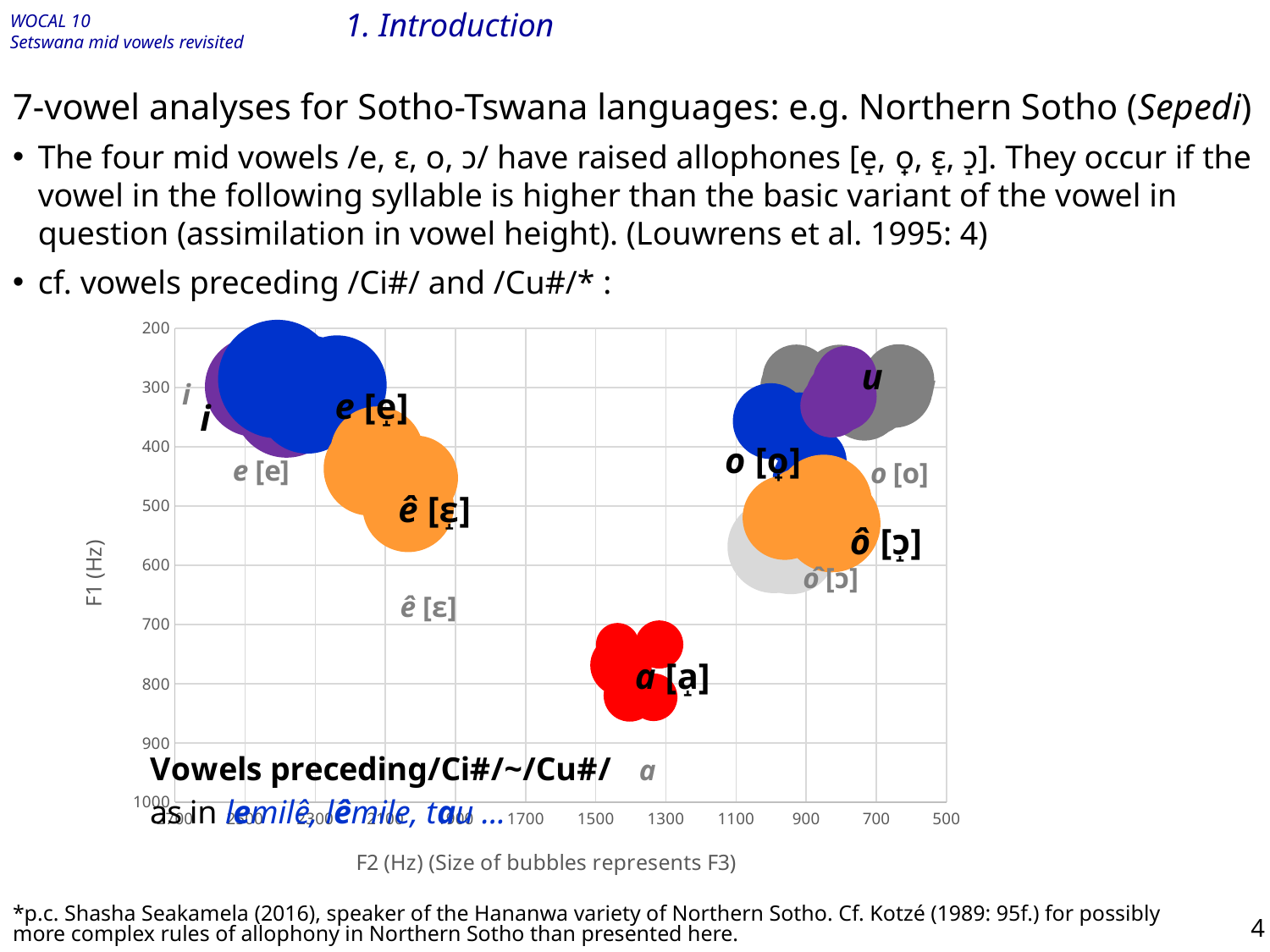
Is the F1 value for the vowel i greater or less than 400? less Is the F2 value for the vowel a [a̝] greater or less than 1700? less What kind of chart is shown on the slide? bubble chart Is the F1 value for the vowel ê [ɛ̝] greater or less than 400? greater Which vowel has the highest F1 value on the chart? a [a̝] What is the title of the vertical axis of the chart? F1 (Hz) Which vowel has the higher F1 value, a [a̝] or i? a [a̝] According to the horizontal axis title, what does the size of the bubbles represent? F3 Which vowel has the higher F2 value, i or u? i